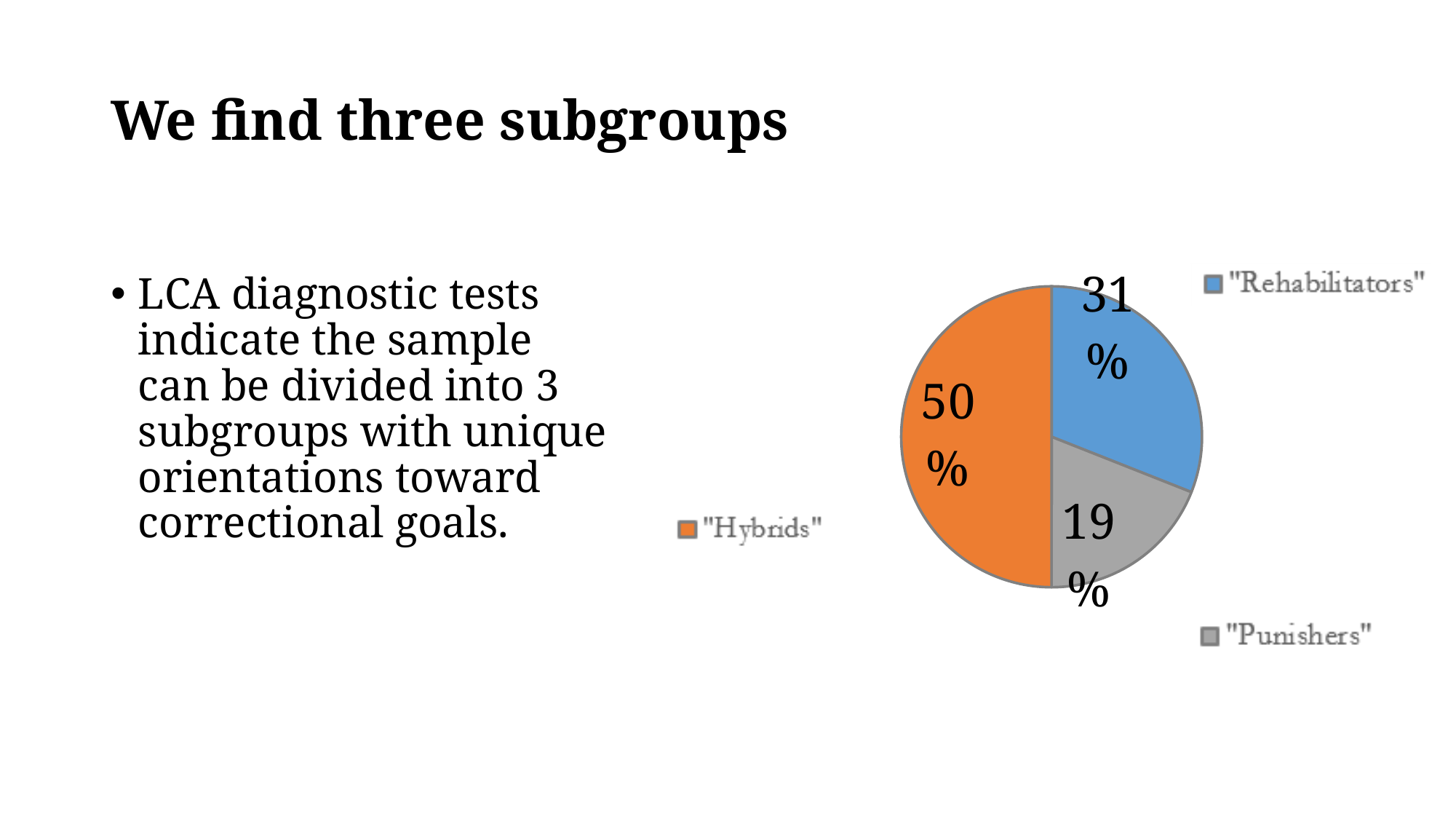
What is the difference in percentage points between the "Hybrids" slice and the "Rehabilitators" slice? 19 What is the difference in percentage points between the "Rehabilitators" slice and the "Punishers" slice? 12 What percentage of the pie is labelled for "Punishers"? 19% Which subgroup is shown in grey in the pie chart? "Punishers" Which subgroup has the largest slice of the pie? "Hybrids" What kind of chart is shown on the slide? pie chart What colour is the "Hybrids" slice in the pie chart? orange How many slices does the pie chart have? 3 What percentage of the pie is labelled for "Hybrids"? 50% Which slice is larger, "Rehabilitators" or "Punishers"? "Rehabilitators" Which subgroup has the smallest slice of the pie? "Punishers" What percentage of the pie is labelled for "Rehabilitators"? 31%